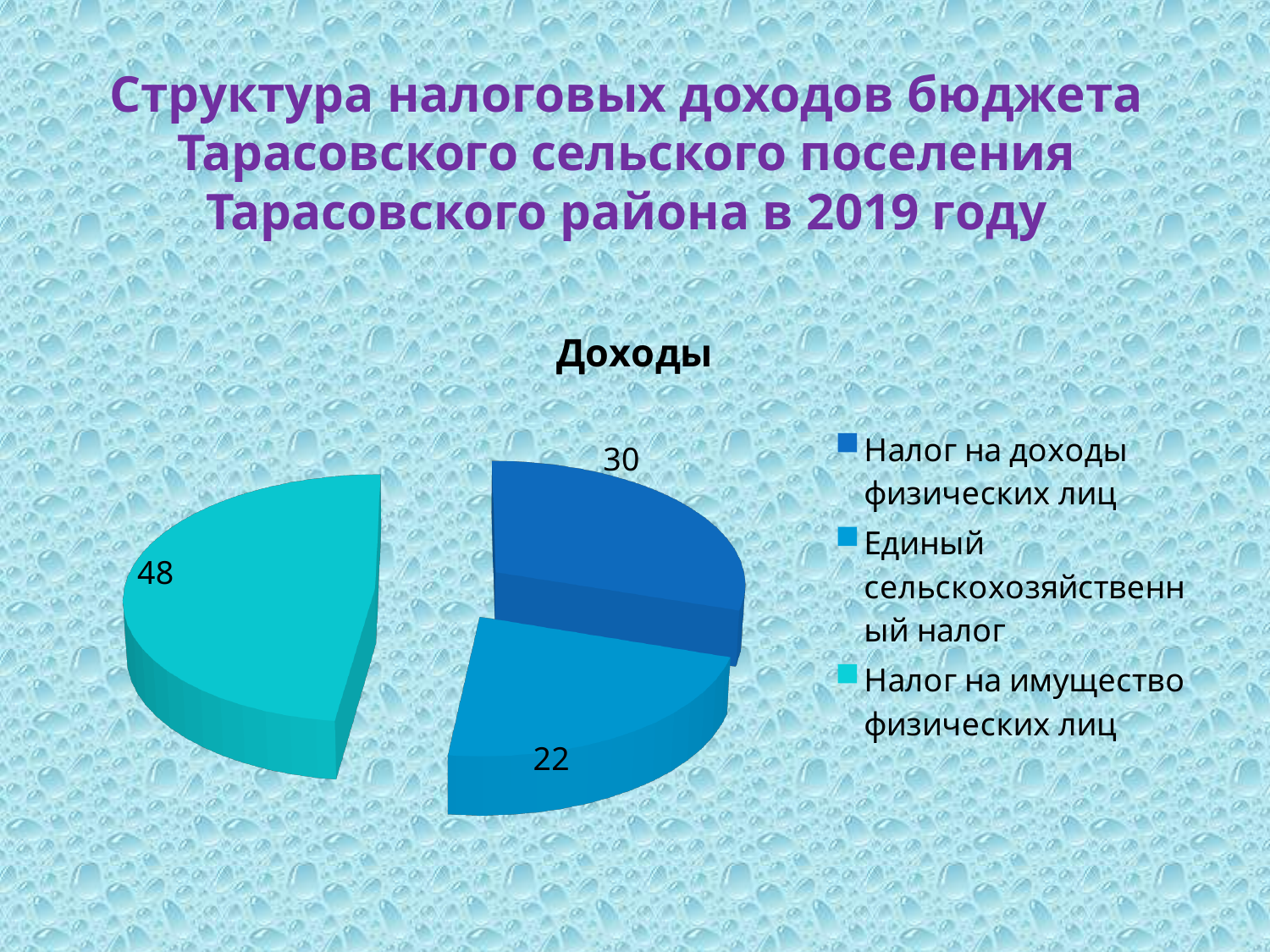
Which is larger: Налог на доходы физических лиц or Единый сельскохозяйственный налог? Налог на доходы физических лиц Which category has the smallest slice of the pie? Единый сельскохозяйственный налог What is the difference between the values for Налог на имущество физических лиц and Налог на доходы физических лиц? 18 What colour is the slice for Налог на имущество физических лиц? Cyan (light turquoise) What is the value for Налог на имущество физических лиц? 48 Which category has the largest slice of the pie? Налог на имущество физических лиц What kind of chart is shown on the slide? Pie chart What share of the pie does Налог на имущество физических лиц represent? 48% What is the value for Налог на доходы физических лиц? 30 What is the title of the chart? Доходы What is the value for Единый сельскохозяйственный налог? 22 How many slices does the pie chart have? 3